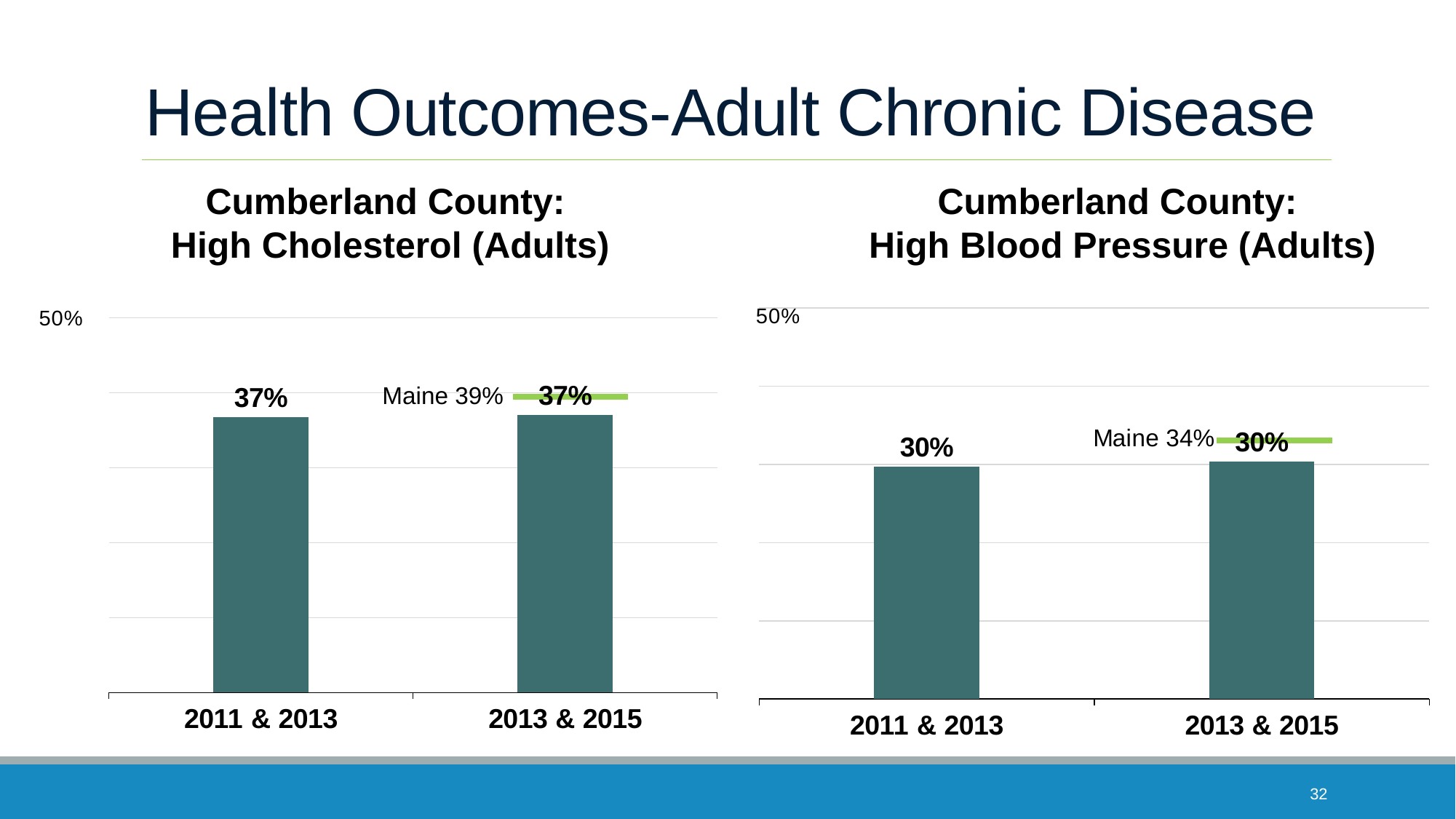
In the High Blood Pressure (Adults) chart, what is the Maine value shown by the green marker? 34% What kind of chart is the High Cholesterol (Adults) chart? bar chart In the High Blood Pressure (Adults) chart, what is the value for 2011 & 2013? 30% In the High Cholesterol (Adults) chart, what is the value for 2011 & 2013? 37% In the High Cholesterol (Adults) chart, what is the Maine value shown by the green marker? 39% In the High Cholesterol (Adults) chart, what is the value for 2013 & 2015? 37% In the High Blood Pressure (Adults) chart, what is the difference between the Maine value and the Cumberland County value for 2013 & 2015? 4% In the High Blood Pressure (Adults) chart, what is the value for 2013 & 2015? 30% In the High Blood Pressure (Adults) chart, do the Cumberland County values rise, fall, or stay the same from 2011 & 2013 to 2013 & 2015? stay the same In the High Cholesterol (Adults) chart, what is the difference between the Maine value and the Cumberland County value for 2013 & 2015? 2% In the High Cholesterol (Adults) chart, is the value for 2011 & 2013 greater or less than 50%? less How many bars are plotted in the High Blood Pressure (Adults) chart? 2